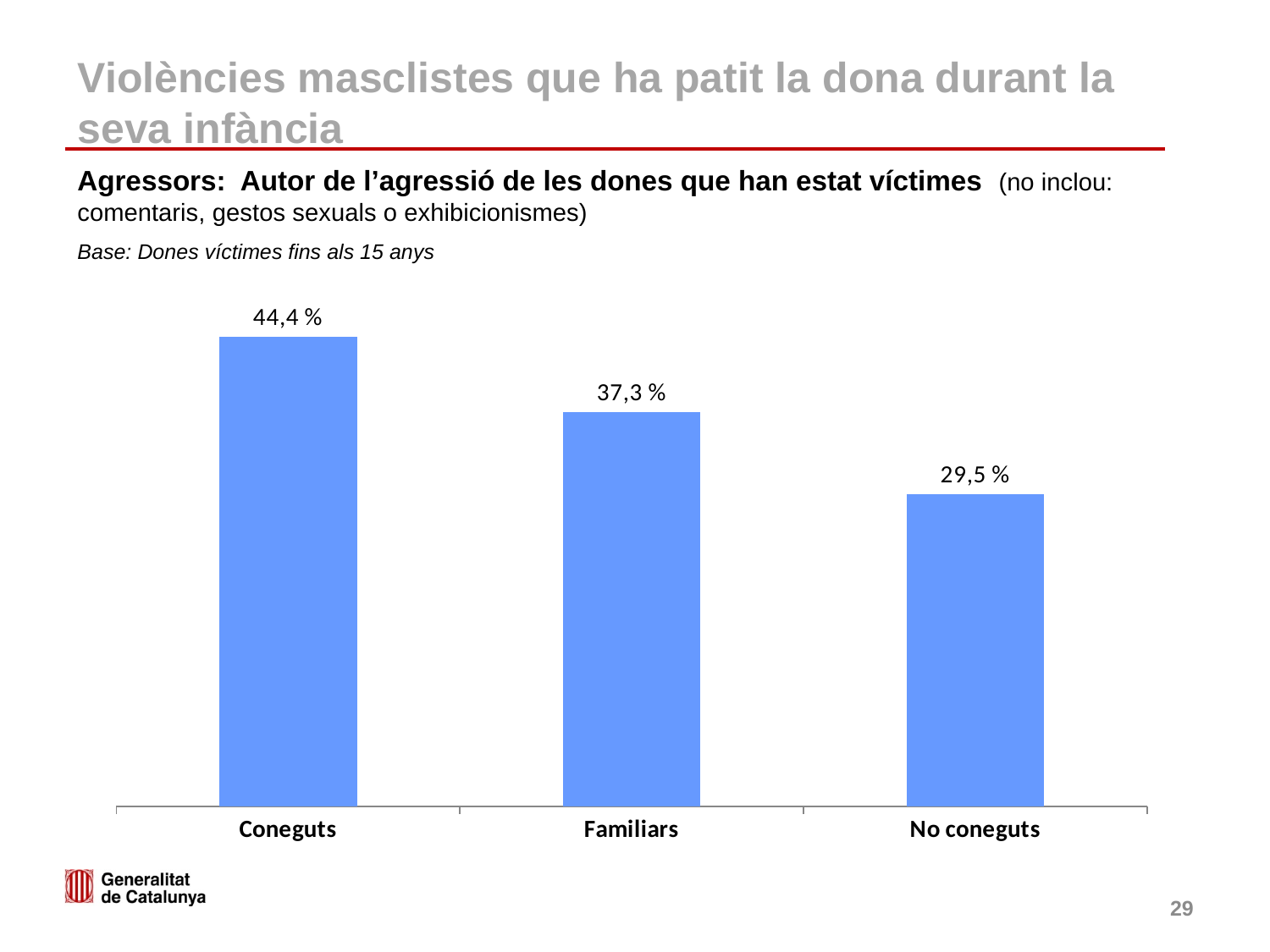
Which is larger, the value for Familiars or the value for No coneguts? Familiars What is the value for No coneguts? 29,5 % Do the values rise or fall from left to right across the categories? Fall What is the value for Coneguts? 44,4 % What is the value for Familiars? 37,3 % What is the difference between the values for Coneguts and Familiars? 7,1 % What is the difference between the values for Coneguts and No coneguts? 14,9 % What kind of chart is shown on the slide? Bar chart What is the base population stated for the chart? Dones víctimes fins als 15 anys How many categories are shown in the chart? 3 Which category has the lowest value? No coneguts Which category has the highest value? Coneguts